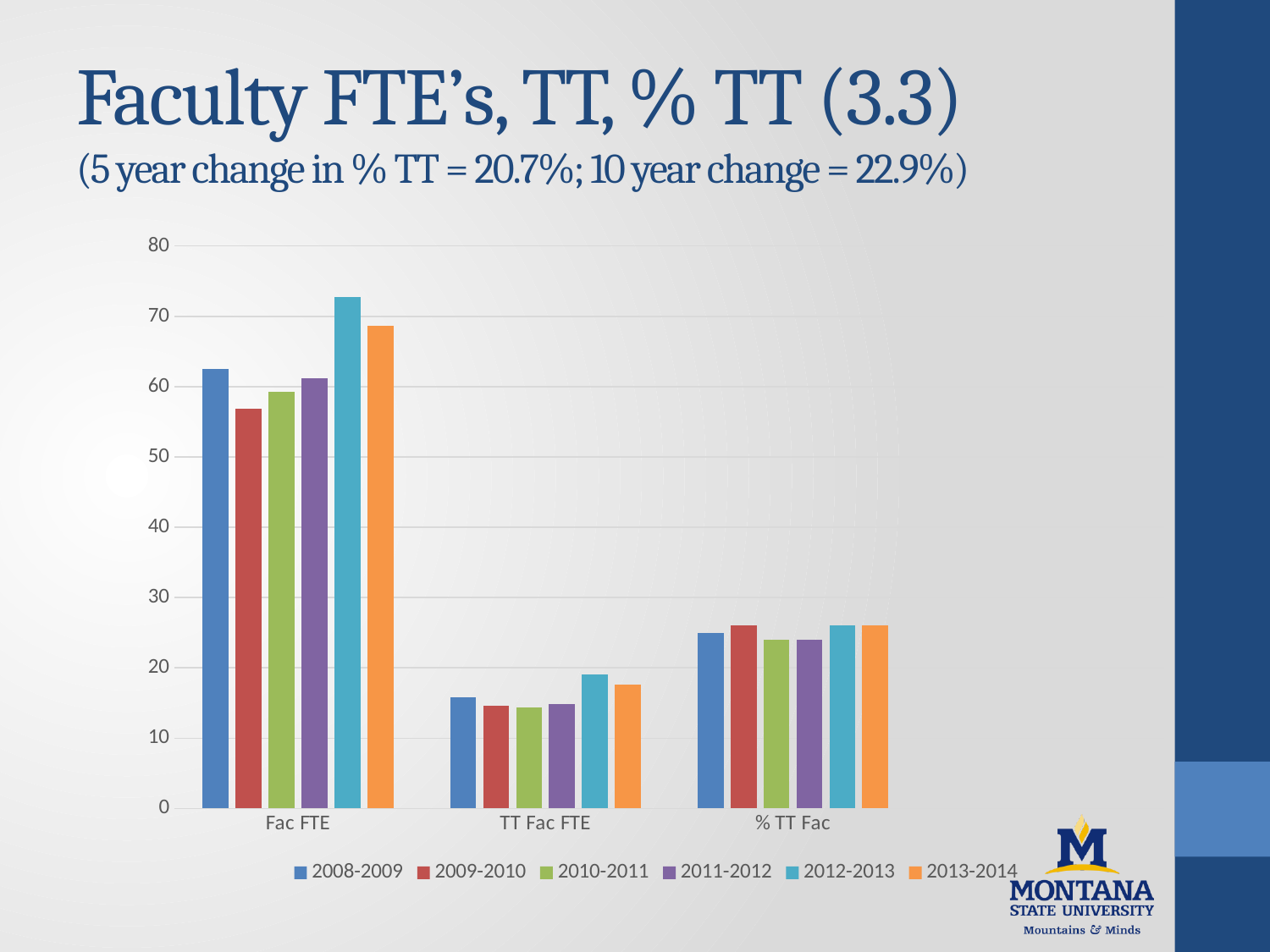
Is the Fac FTE value for 2009-2010 greater or less than 60? less Is the TT Fac FTE value for 2012-2013 greater or less than 20? less What kind of chart is shown on the slide? bar chart Within the TT Fac FTE category, which year has the highest bar? 2012-2013 In the Fac FTE category, which is larger: the 2008-2009 bar or the 2013-2014 bar? 2013-2014 How many series does the legend list? 6 Within the Fac FTE category, which year has the highest bar? 2012-2013 In the TT Fac FTE category, which is larger: the 2012-2013 bar or the 2013-2014 bar? 2012-2013 Within the Fac FTE category, which year has the lowest bar? 2009-2010 How many categories are shown on the x axis? 3 Is the Fac FTE value for 2012-2013 greater or less than 70? greater What is the title of the slide containing the chart? Faculty FTE's, TT, % TT (3.3)